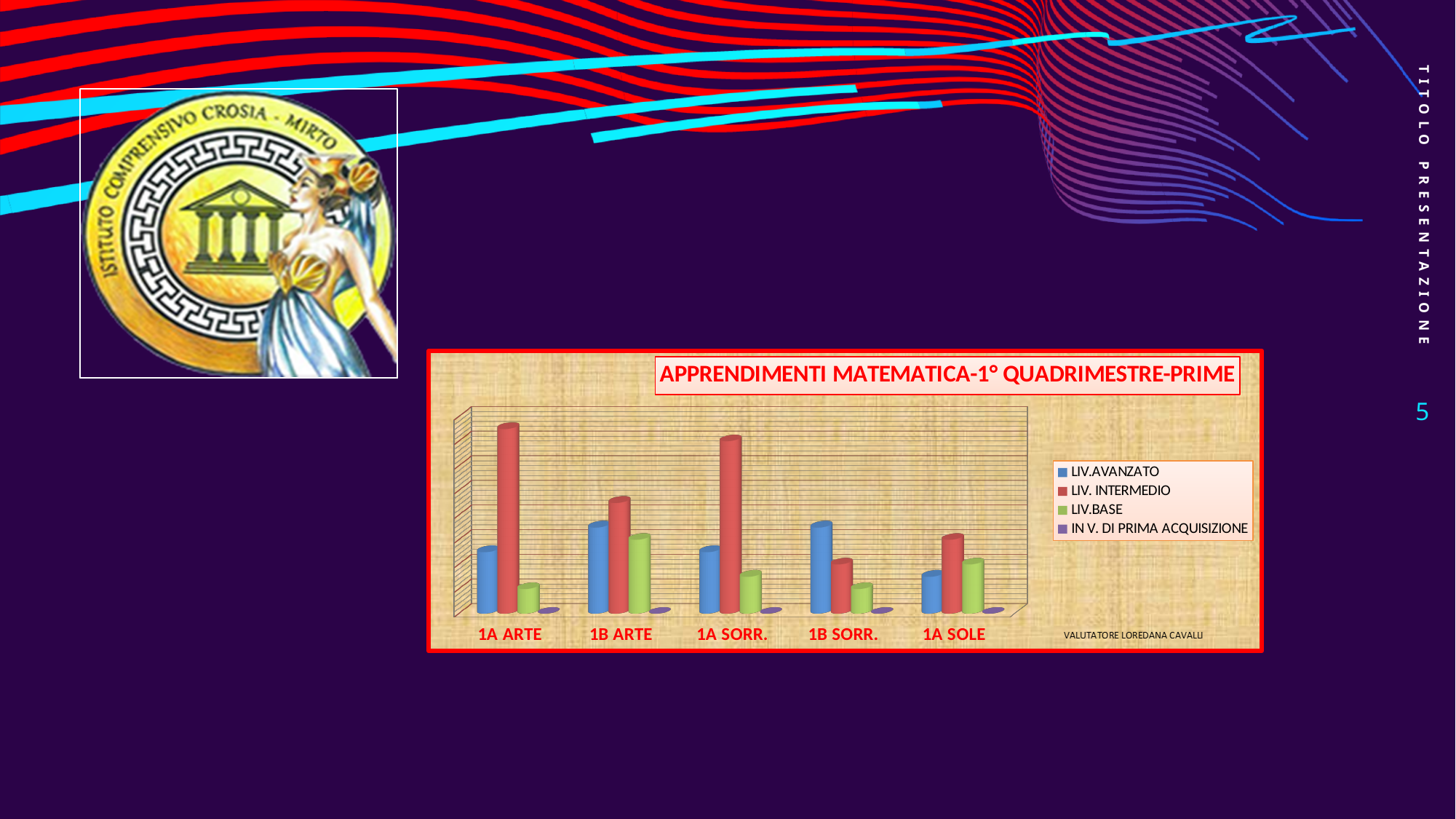
How many classes (categories) are shown on the x axis of the chart? 5 Which class has the shortest LIV. INTERMEDIO bar? 1B SORR. Which class has the tallest LIV. INTERMEDIO bar? 1A ARTE For 1A ARTE, which is larger: LIV.AVANZATO or LIV. INTERMEDIO? LIV. INTERMEDIO What is the title of the chart? APPRENDIMENTI MATEMATICA-1° QUADRIMESTRE-PRIME How many series does the chart legend list? 4 What kind of chart is shown on the slide? bar chart Which class has the tallest LIV.BASE bar? 1B ARTE Which colour represents LIV.BASE in the chart legend? green For 1B SORR., which is larger: LIV.AVANZATO or LIV. INTERMEDIO? LIV.AVANZATO Which class has the shortest LIV.AVANZATO bar? 1A SOLE For 1A SOLE, which is larger: LIV.AVANZATO or LIV.BASE? LIV.BASE